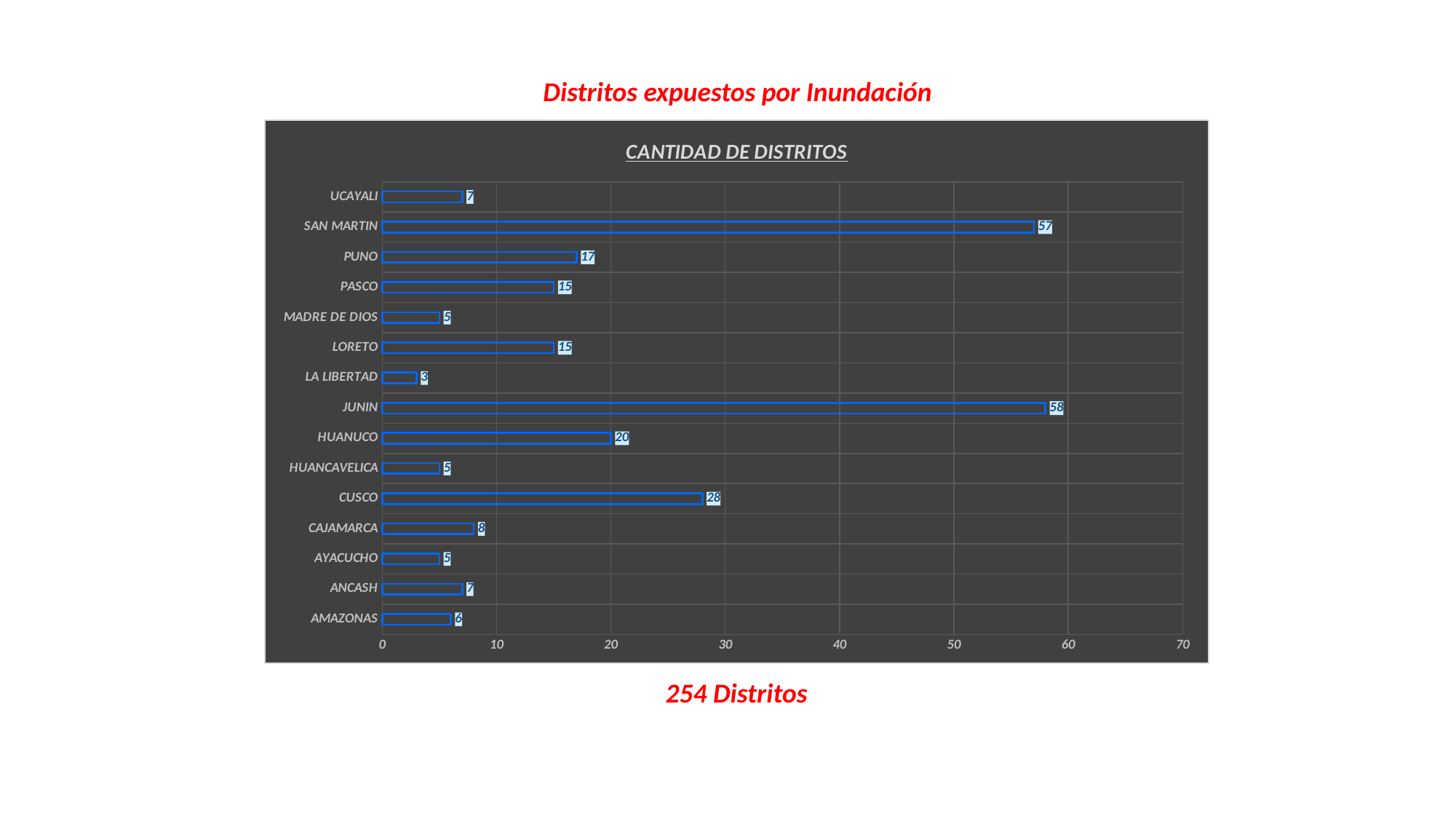
What is the value for SAN MARTIN? 57 What is the difference between the values for JUNIN and SAN MARTIN? 1 What is the difference between the values for CUSCO and PUNO? 11 What is the value for CUSCO? 28 What is the title of the chart? CANTIDAD DE DISTRITOS Which is larger, the value for PUNO or the value for PASCO? PUNO What is the value for HUANUCO? 20 Is the value for HUANUCO greater or less than 10? greater How many categories are shown in the chart? 15 Which category has the lowest value? LA LIBERTAD What kind of chart is shown on the slide? bar chart Which category has the highest value? JUNIN